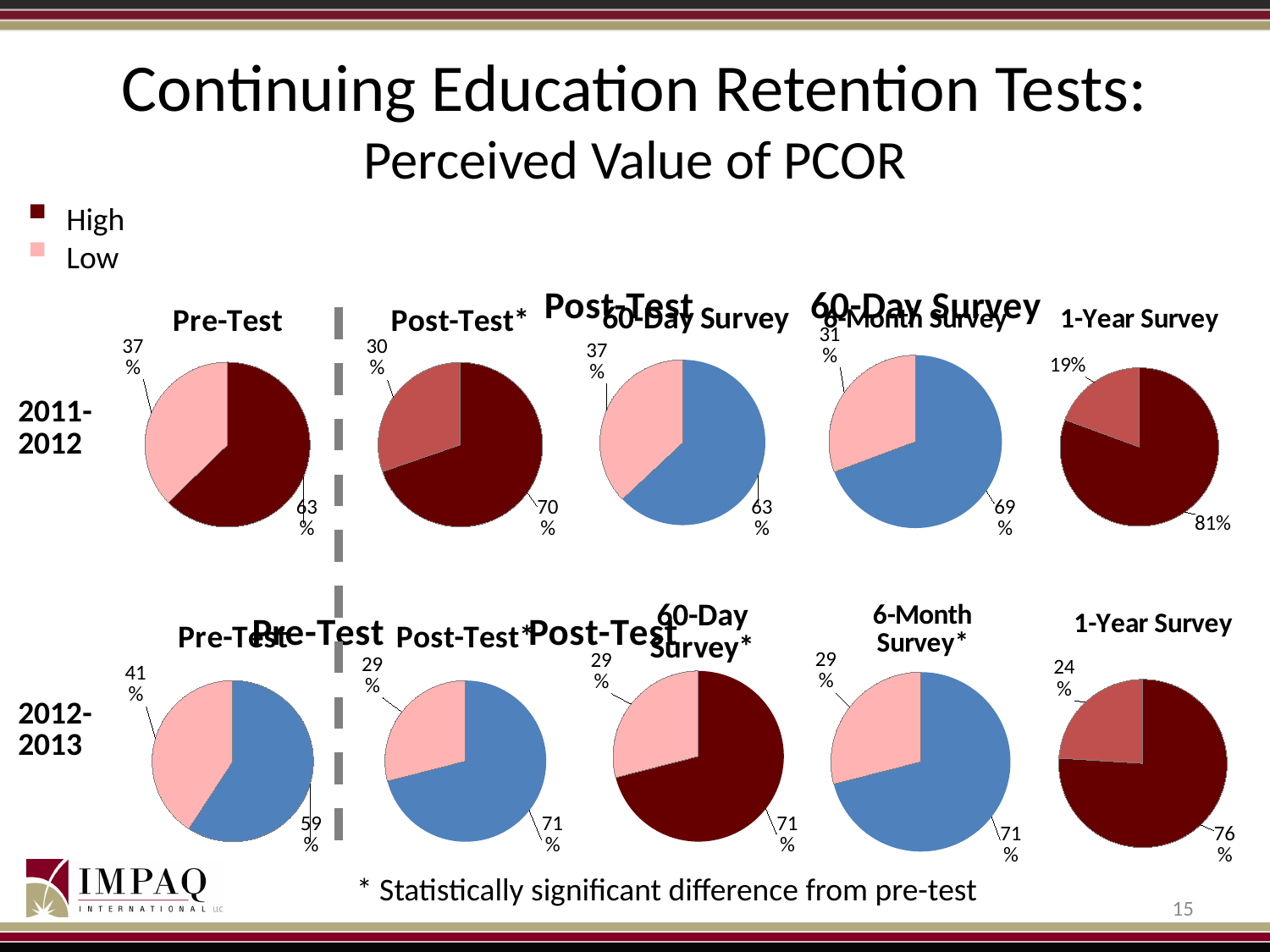
What are the two legend entries on the slide? High and Low Which is larger: the larger slice in the 2011-2012 1-Year Survey pie or the larger slice in the 2012-2013 1-Year Survey pie? 2011-2012 1-Year Survey In the 2011-2012 Post-Test* pie chart, what is the percentage of the larger slice? 70% What kind of chart is used to show the Perceived Value of PCOR on this slide? Pie chart In the 2011-2012 1-Year Survey pie chart, what percentage is labelled for the Low slice? 19% What is the difference between the larger slice of the 2011-2012 1-Year Survey pie (81%) and the larger slice of the 2011-2012 Pre-Test pie (63%)? 18 percentage points In the 2011-2012 Pre-Test pie chart, what is the percentage of the larger slice? 63% How many entries does the legend list? 2 In the 2012-2013 Pre-Test pie chart, what is the percentage of the smaller slice? 41% How many pie charts are shown on the slide in total? 10 In the 2012-2013 1-Year Survey pie chart, what is the percentage of the larger slice? 76% In the 2011-2012 1-Year Survey pie chart, what percentage is labelled for the High slice? 81%